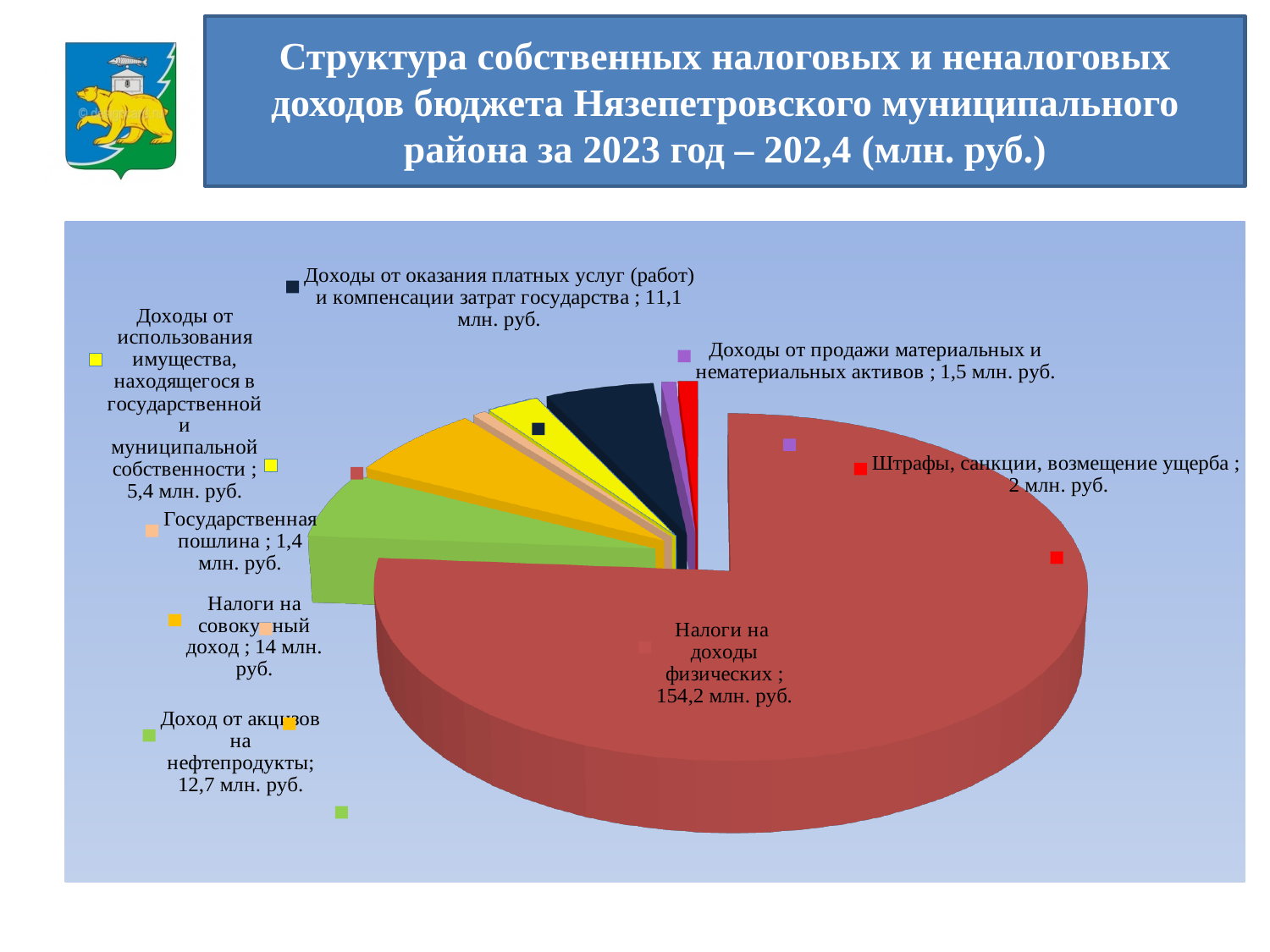
Which category has the smallest value in the pie chart? Государственная пошлина Which category has the largest slice of the pie? Налоги на доходы физических лиц What is the value for «Штрафы, санкции, возмещение ущерба»? 2 млн. руб. What kind of chart is shown on the slide? Pie chart What is the value for «Доход от акцизов на нефтепродукты»? 12,7 млн. руб. What is the value for «Доходы от продажи материальных и нематериальных активов»? 1,5 млн. руб. What is the difference between «Налоги на совокупный доход» and «Доход от акцизов на нефтепродукты»? 1,3 млн. руб. What is the value for «Доходы от оказания платных услуг (работ) и компенсации затрат государства»? 11,1 млн. руб. What total amount of own tax and non-tax revenues for 2023 is stated in the slide title? 202,4 (млн. руб.) How many categories (slices) does the pie chart show? 8 What is the value for «Налоги на доходы физических лиц»? 154,2 млн. руб. Which is larger: «Доходы от оказания платных услуг» or «Доходы от использования имущества»? Доходы от оказания платных услуг